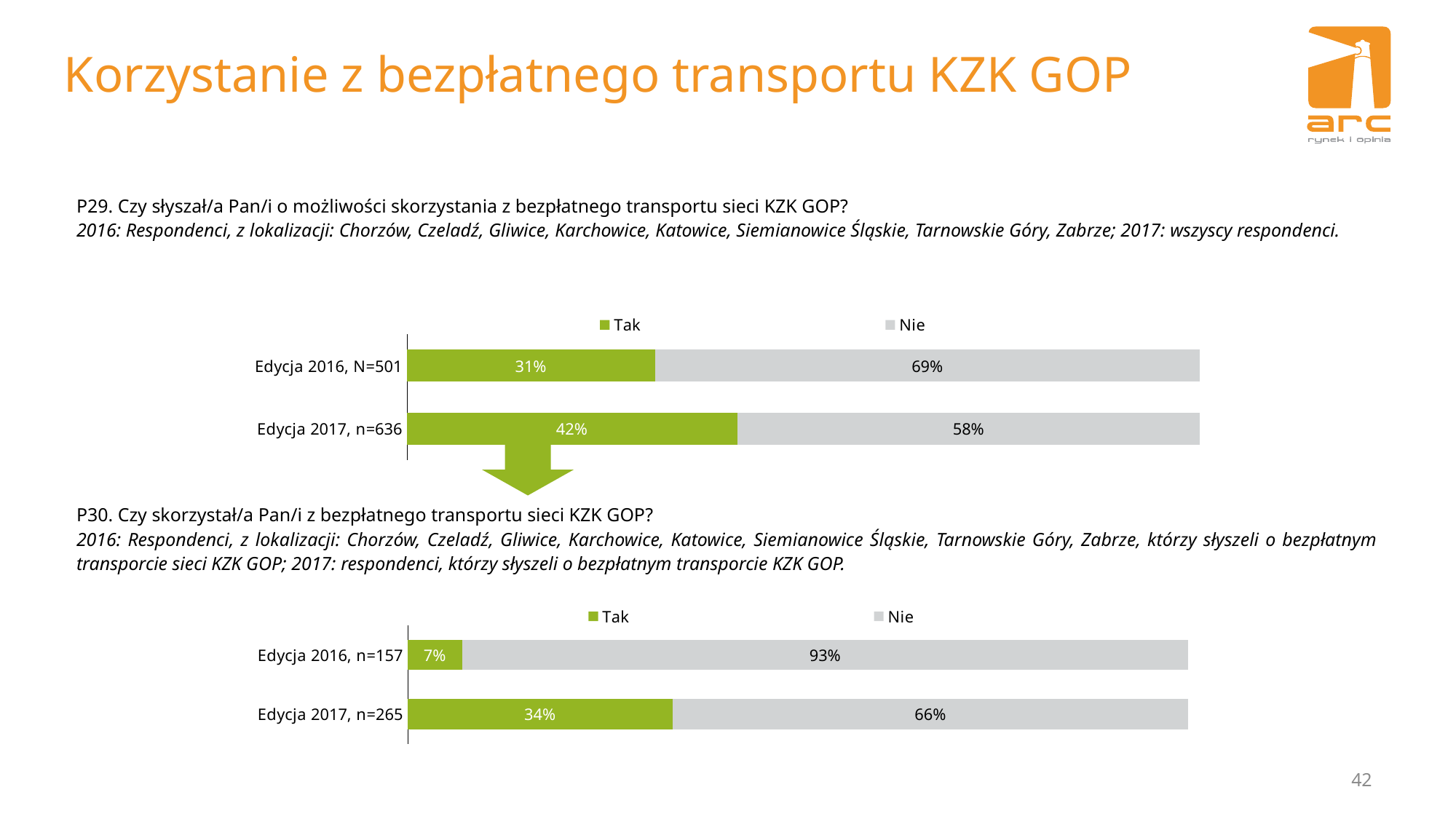
In the bottom chart (P30), what is the value for Nie for Edycja 2017, n=265? 66% In the bottom chart (P30), what is the difference between the Tak values for Edycja 2017, n=265 and Edycja 2016, n=157? 27 percentage points In the bottom chart (P30), which edition has the higher Nie value? Edycja 2016, n=157 In the top chart (P29), what is the total of the stacked bar for Edycja 2016, N=501? 100% In the top chart (P29), what is the value for Tak for Edycja 2016, N=501? 31% How many categories are shown in the bottom chart (P30)? 2 How many series does the legend of the top chart (P29) list? 2 In the top chart (P29), what is the value for Nie for Edycja 2017, n=636? 58% In the bottom chart (P30), what is the value for Tak for Edycja 2016, n=157? 7% In the top chart (P29), which edition has the lower Tak value? Edycja 2016, N=501 In the top chart (P29), what is the difference between the Tak values for Edycja 2017, n=636 and Edycja 2016, N=501? 11 percentage points What kind of chart is the top chart (P29)? Stacked bar chart